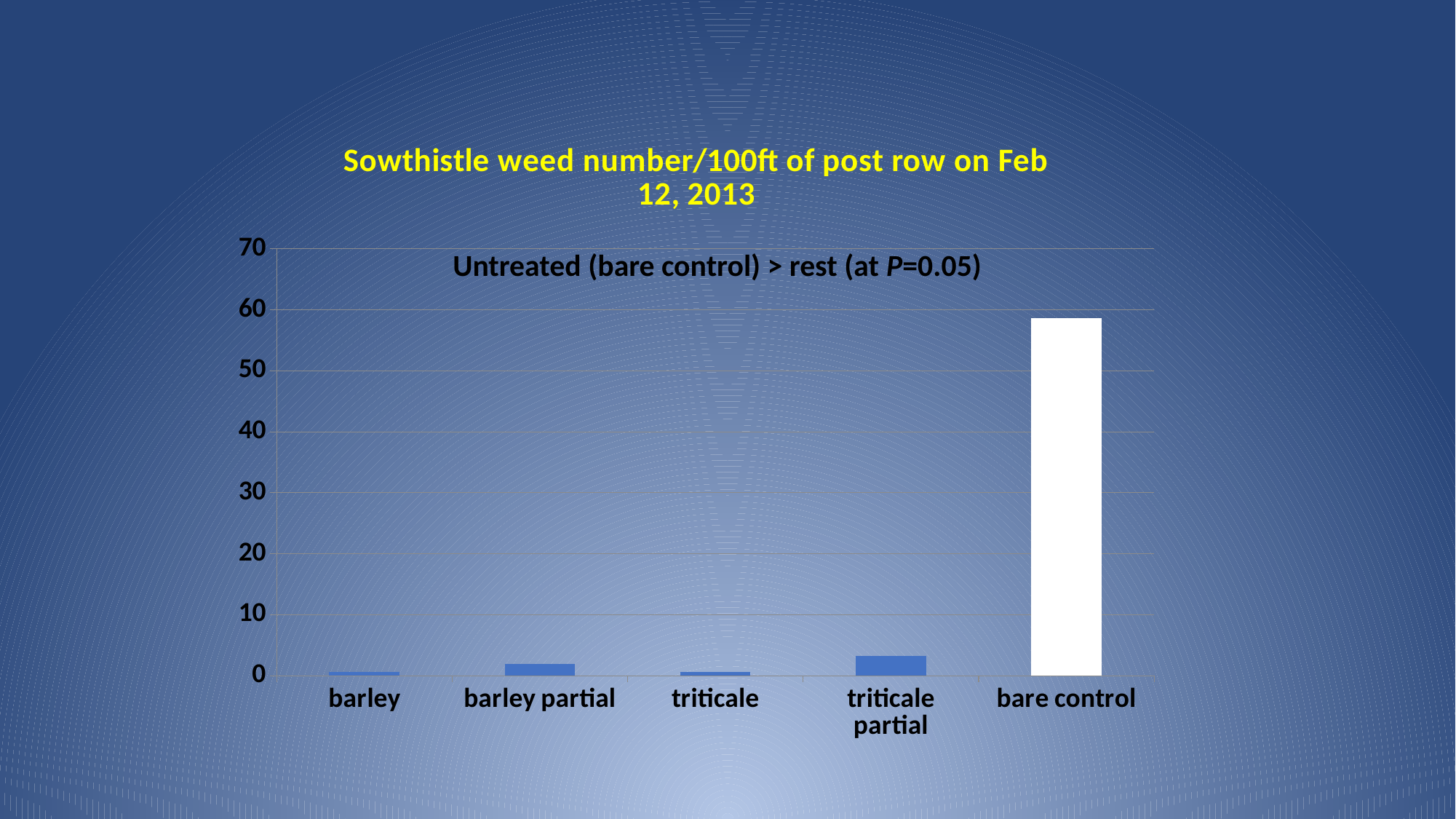
Which is larger, the value for barley partial or the value for barley? barley partial Is the value for barley partial greater or less than 10? less What is the title of the chart? Sowthistle weed number/100ft of post row on Feb 12, 2013 What kind of chart is shown on the slide? bar chart Which is larger, the value for triticale partial or the value for triticale? triticale partial Is the value for triticale partial greater or less than 10? less Which category has the highest sowthistle weed number? bare control Is the value for bare control greater or less than 50? greater Which is larger, the value for bare control or the value for barley? bare control What statistical note is written inside the plot area of the chart? Untreated (bare control) > rest (at P=0.05) How many categories are plotted on the x axis? 5